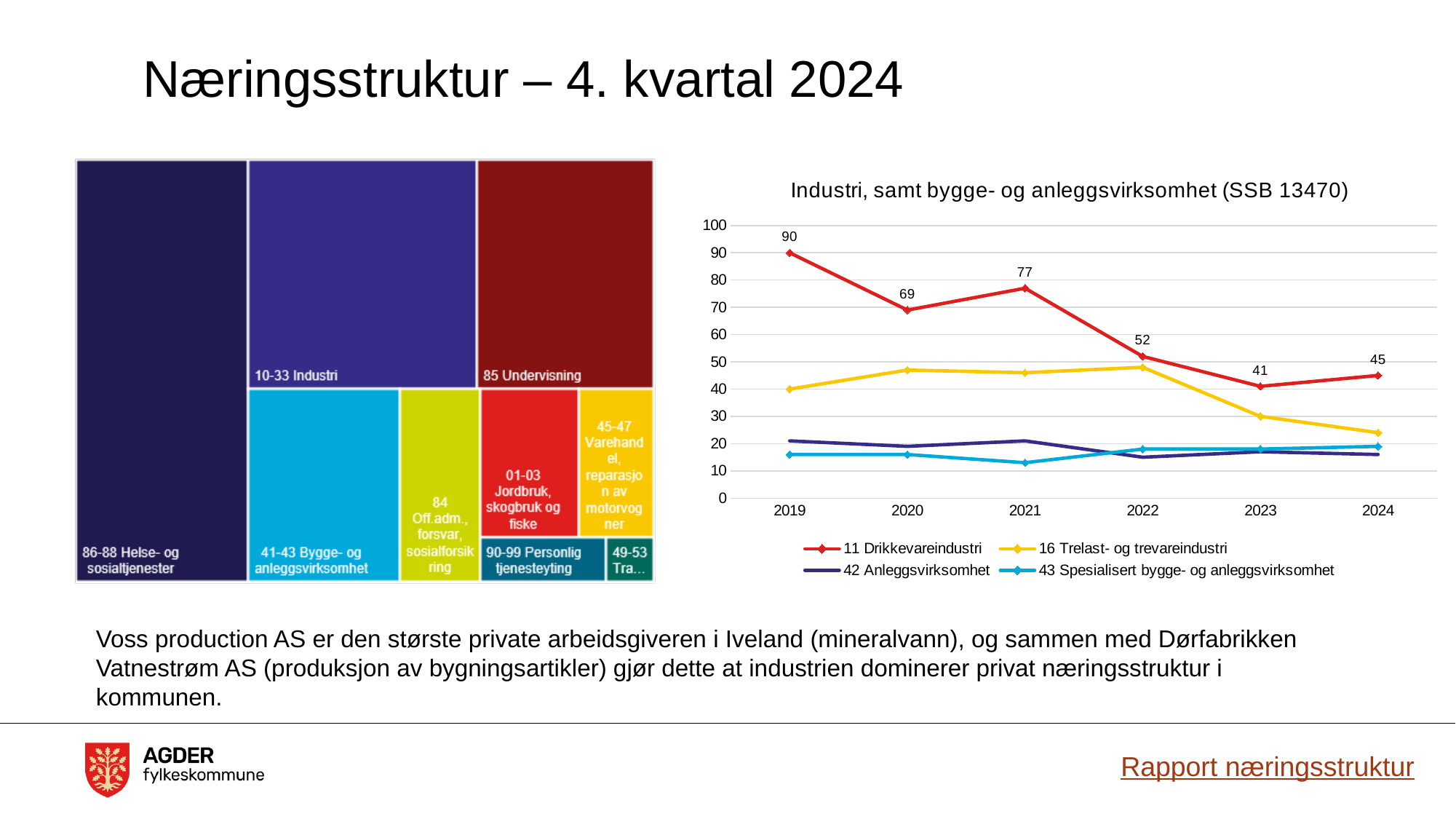
In the line chart on the right, what is the difference between the 11 Drikkevareindustri values for 2021 and 2022? 25 In the line chart 'Industri, samt bygge- og anleggsvirksomhet (SSB 13470)', what is the value for 11 Drikkevareindustri in 2019? 90 In the line chart on the right, in which year is 11 Drikkevareindustri at its highest? 2019 In the line chart on the right, in which year is 11 Drikkevareindustri at its lowest? 2023 In the line chart on the right, what is the value for 11 Drikkevareindustri in 2023? 41 How many series does the legend of the line chart on the right list? 4 What kind of chart is the chart on the right of the slide? Line chart How many years are shown on the x axis of the line chart on the right? 6 In the line chart on the right, does the 11 Drikkevareindustri series generally rise or fall from 2019 to 2024? Fall In the line chart on the right, is the value for 16 Trelast- og trevareindustri in 2020 greater or less than 40? greater In the line chart on the right, is the value for 16 Trelast- og trevareindustri in 2023 greater or less than 40? less In the line chart on the right, which is larger for 11 Drikkevareindustri: the 2020 value or the 2021 value? 2021